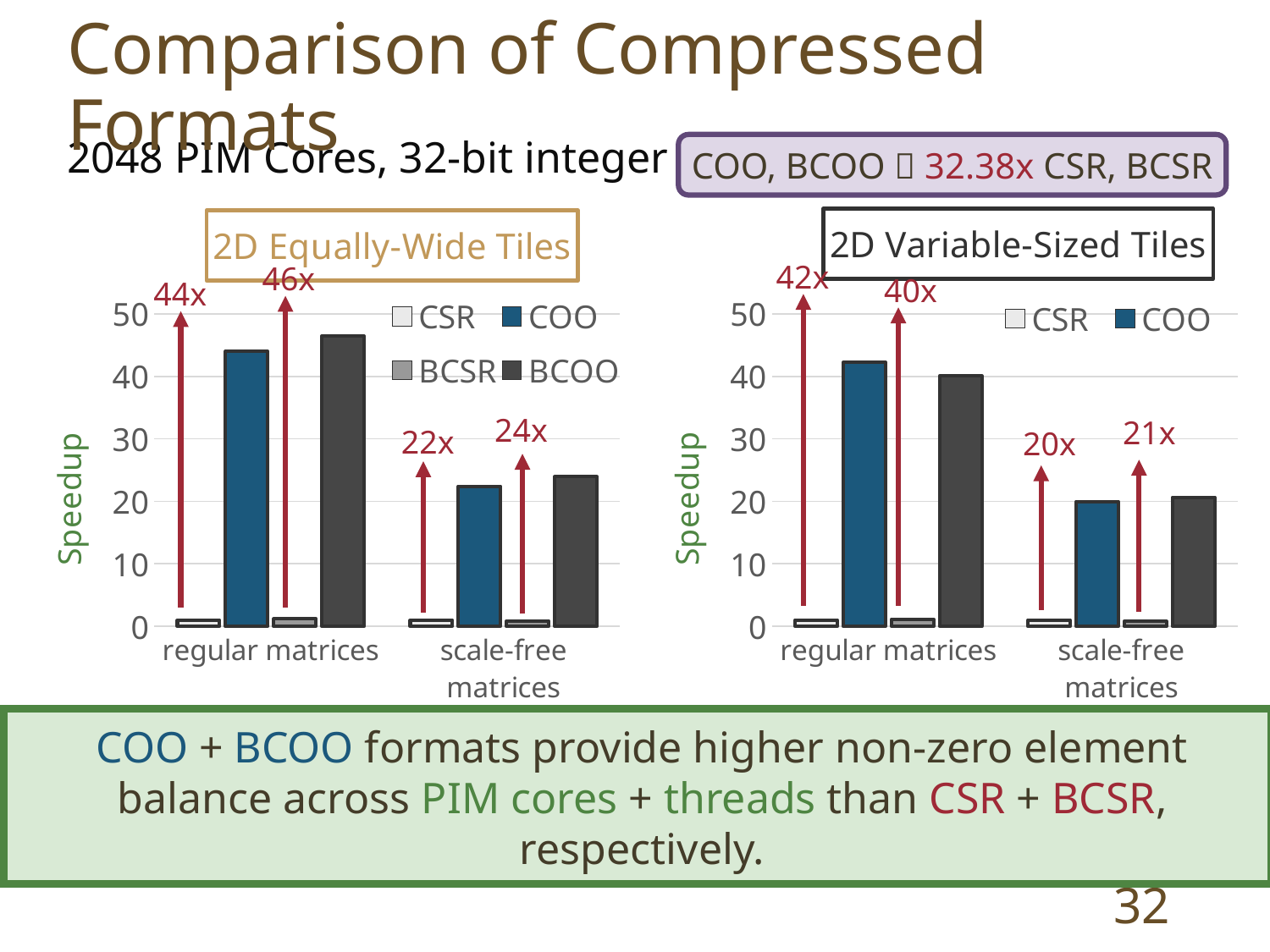
How many series does the legend of the 2D Equally-Wide Tiles chart list? 4 In the 2D Variable-Sized Tiles chart, is the BCOO value for scale-free matrices greater or less than 30? less In the 2D Equally-Wide Tiles chart, what speedup annotation is printed above the arrow for COO on regular matrices? 44x How many categories are shown on the x axis of the 2D Variable-Sized Tiles chart? 2 In the 2D Equally-Wide Tiles chart, is the COO value for regular matrices greater or less than 40? greater In the 2D Variable-Sized Tiles chart, what speedup annotation is printed above the arrow for BCOO on scale-free matrices? 21x What kind of chart is the 2D Equally-Wide Tiles chart? bar chart In the 2D Variable-Sized Tiles chart, is the COO value for regular matrices greater or less than 30? greater In the 2D Variable-Sized Tiles chart, which is larger for regular matrices, the COO bar or the CSR bar? COO What is the y-axis label of the 2D Variable-Sized Tiles chart? Speedup In the 2D Equally-Wide Tiles chart, which category has the larger COO value, regular matrices or scale-free matrices? regular matrices